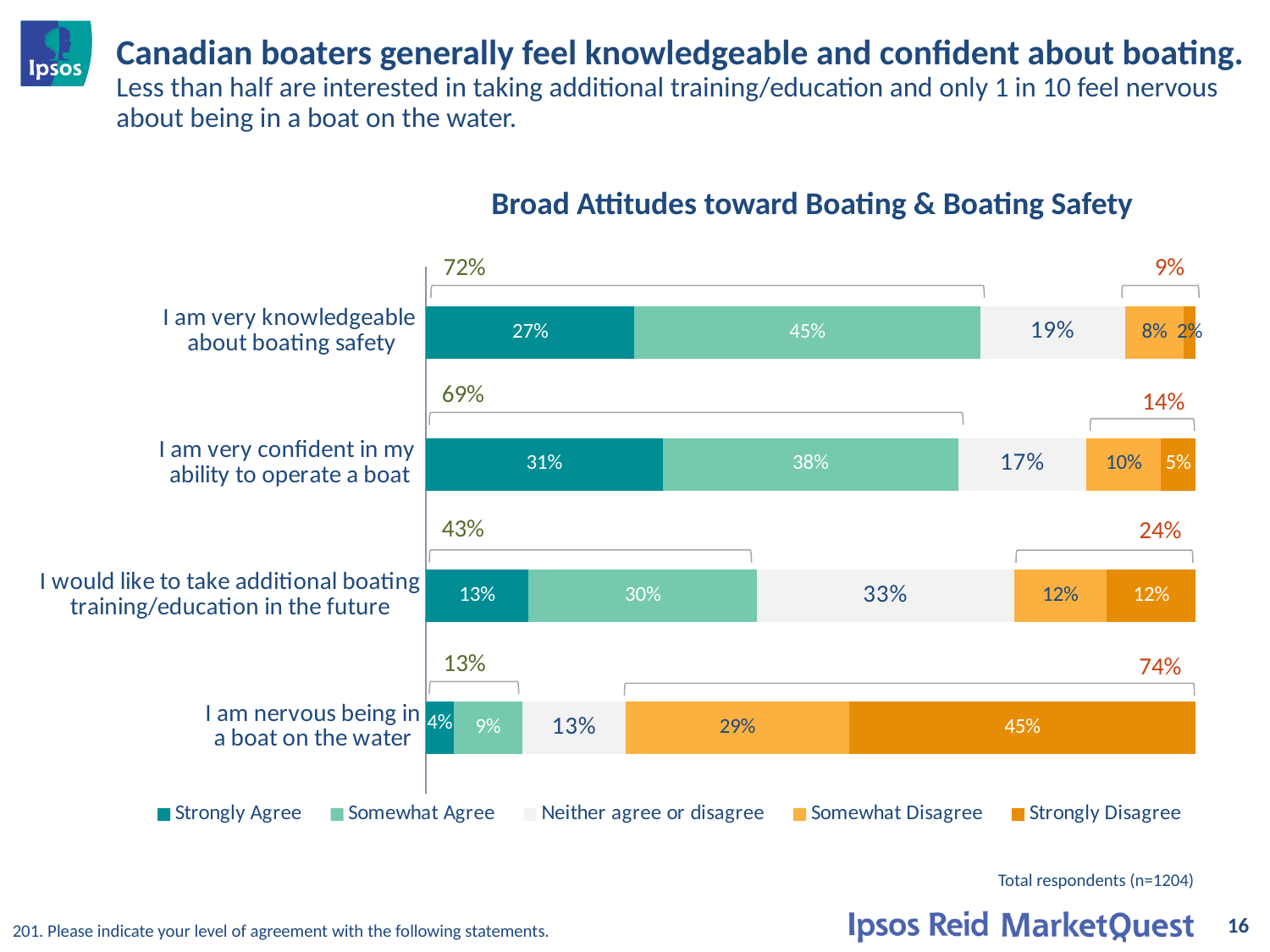
How many statements are shown in the chart? 4 What is the title of the chart? Broad Attitudes toward Boating & Boating Safety What is the difference between the Strongly Agree percentages for 'I am very confident in my ability to operate a boat' and 'I am very knowledgeable about boating safety'? 4% What percentage of respondents neither agree nor disagree that they would like to take additional boating training/education in the future? 33% What percentage of respondents strongly agree that they are very knowledgeable about boating safety? 27% What kind of chart is shown on the slide? Stacked bar chart Which statement has the lowest combined agreement (Strongly Agree plus Somewhat Agree)? I am nervous being in a boat on the water Which statement has the highest combined agreement (Strongly Agree plus Somewhat Agree)? I am very knowledgeable about boating safety Which is larger: the Somewhat Disagree percentage for 'I am nervous being in a boat on the water' or the Somewhat Disagree percentage for 'I would like to take additional boating training/education in the future'? I am nervous being in a boat on the water How many series does the legend list? 5 What percentage of respondents somewhat agree that they are very confident in their ability to operate a boat? 38% What percentage of respondents strongly disagree that they are nervous being in a boat on the water? 45%